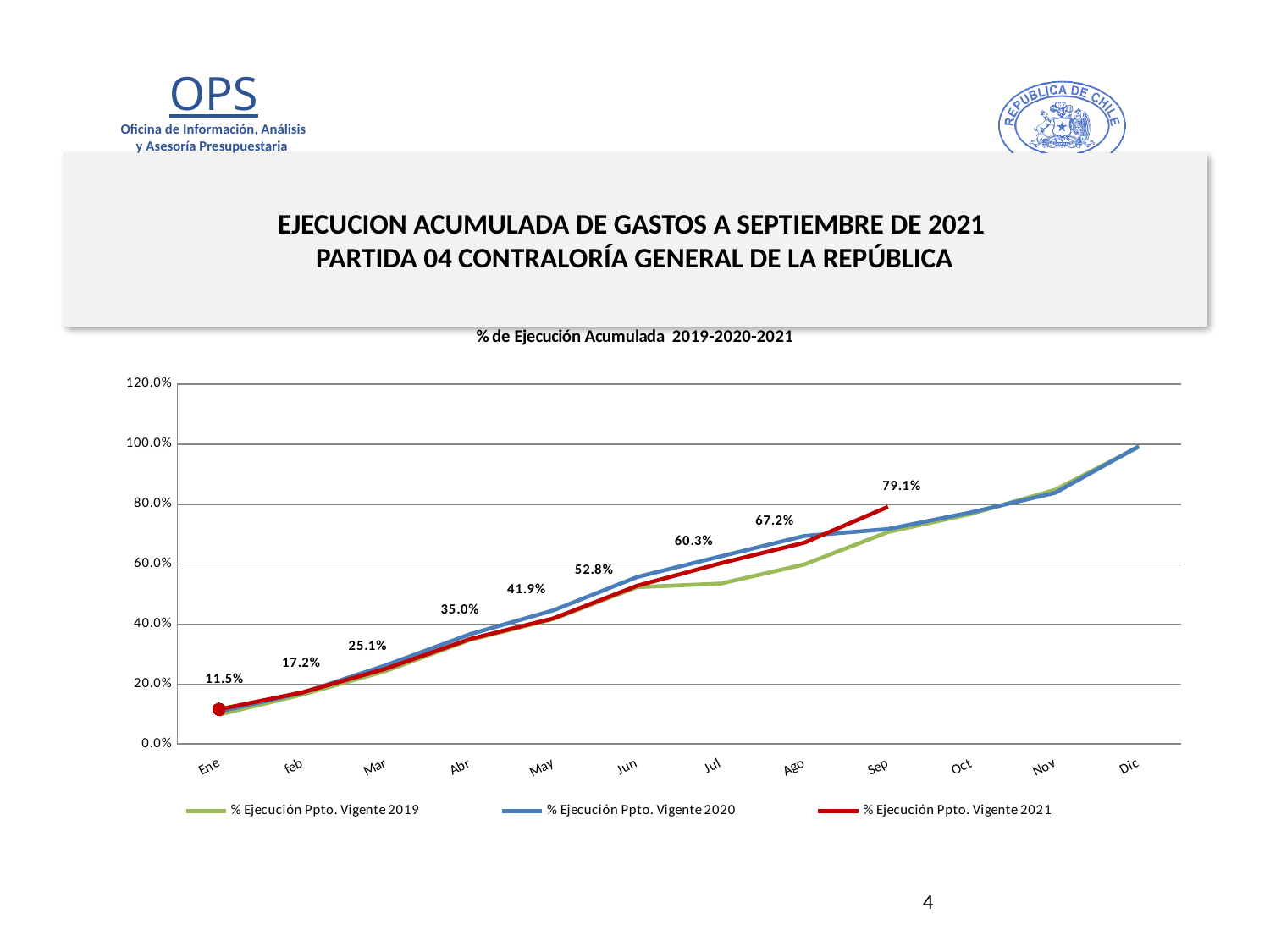
What is the value for % Ejecución Ppto. Vigente 2021 in Ene? 11.5% What is the value for % Ejecución Ppto. Vigente 2021 in Jul? 60.3% What is the difference between the 2021 values for Jun and Mar? 27.7% Is the value for % Ejecución Ppto. Vigente 2020 in Dic greater or less than 80.0%? greater What is the title of the chart? % de Ejecución Acumulada 2019-2020-2021 Which month has the highest value for % Ejecución Ppto. Vigente 2021? Sep What is the value for % Ejecución Ppto. Vigente 2021 in May? 41.9% What is the value for % Ejecución Ppto. Vigente 2021 in Sep? 79.1% Does the value for % Ejecución Ppto. Vigente 2021 rise or fall from Ene to Sep? rise What is the difference between the 2021 values for Sep and Ago? 11.9% How many series does the legend list? 3 What kind of chart is shown on the slide? line chart